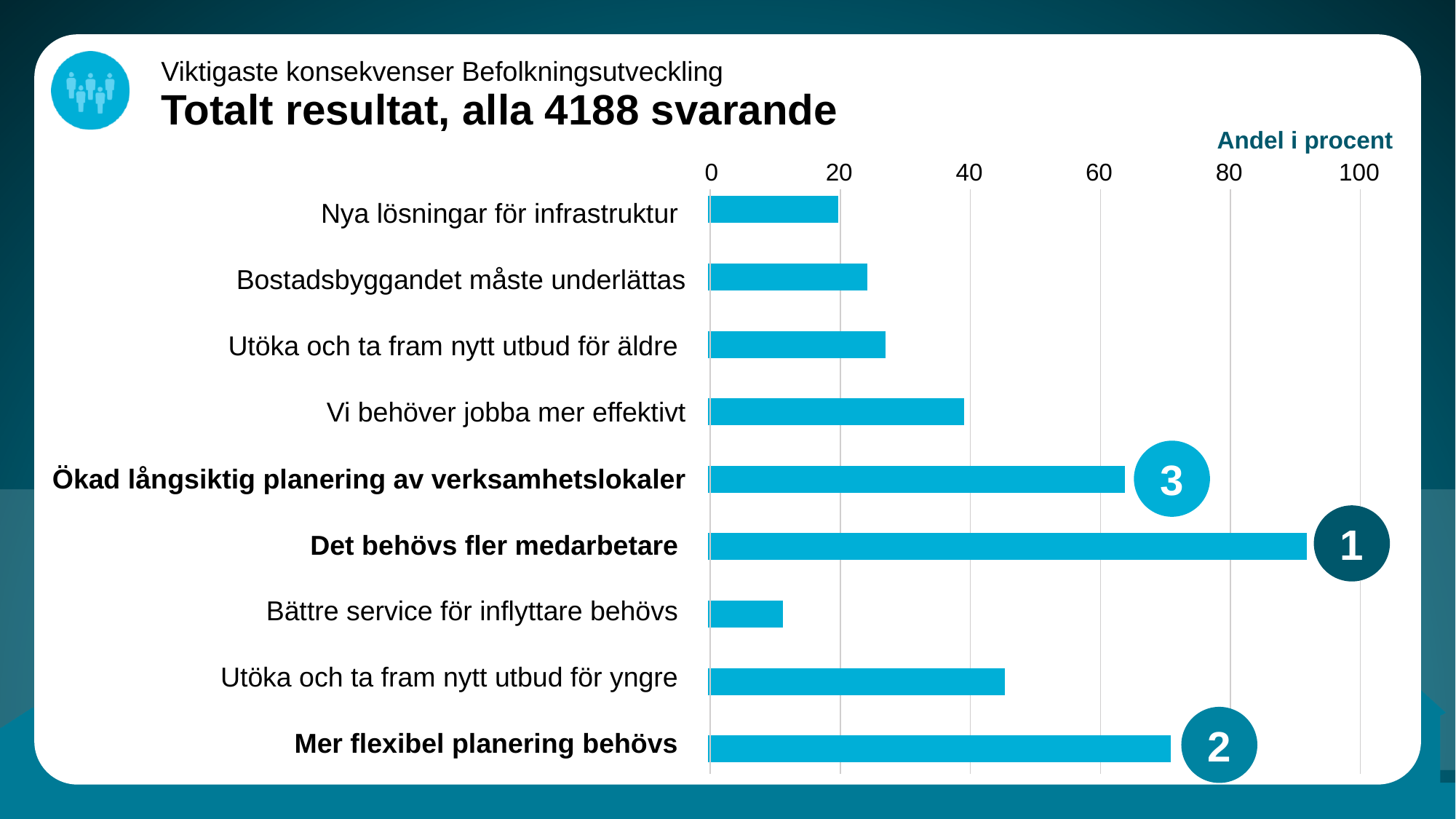
How many categories are plotted in the chart? 9 What kind of chart is shown on the slide? bar chart Is the value for 'Bättre service för inflyttare behövs' greater or less than 20? less Is the value for 'Utöka och ta fram nytt utbud för yngre' greater or less than 40? greater What label is shown above the horizontal axis of the chart? Andel i procent Which is larger: the value for 'Ökad långsiktig planering av verksamhetslokaler' or the value for 'Mer flexibel planering behövs'? Mer flexibel planering behövs Which category has the lowest value in the chart? Bättre service för inflyttare behövs Is the value for 'Det behövs fler medarbetare' greater or less than 80? greater Which is larger: the value for 'Utöka och ta fram nytt utbud för äldre' or the value for 'Utöka och ta fram nytt utbud för yngre'? Utöka och ta fram nytt utbud för yngre Which category has the highest value in the chart? Det behövs fler medarbetare